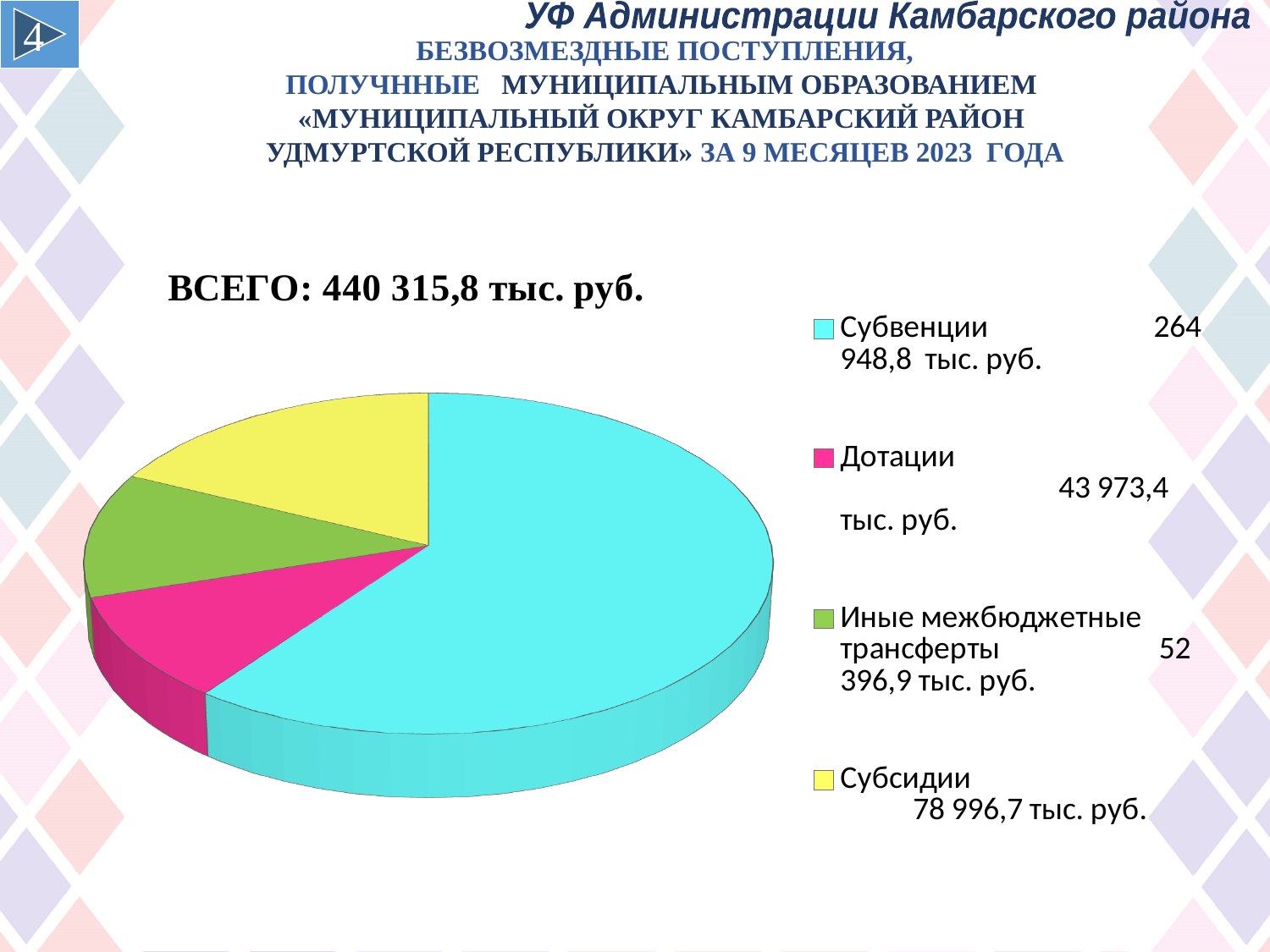
What is the total of all categories shown (ВСЕГО)? 440 315,8 тыс. руб. Which is larger, Субсидии or Иные межбюджетные трансферты? Субсидии What is the value for Дотации? 43 973,4 тыс. руб. Which category has the largest value? Субвенции What is the value for Субсидии? 78 996,7 тыс. руб. What is the value for Субвенции? 264 948,8 тыс. руб. What is the value for Иные межбюджетные трансферты? 52 396,9 тыс. руб. What colour is the slice for Субсидии? yellow Which category has the smallest value? Дотации What is the difference between Субвенции and Дотации? 220 975,4 тыс. руб. How many categories does the pie chart show? 4 What type of chart is shown on the slide? pie chart